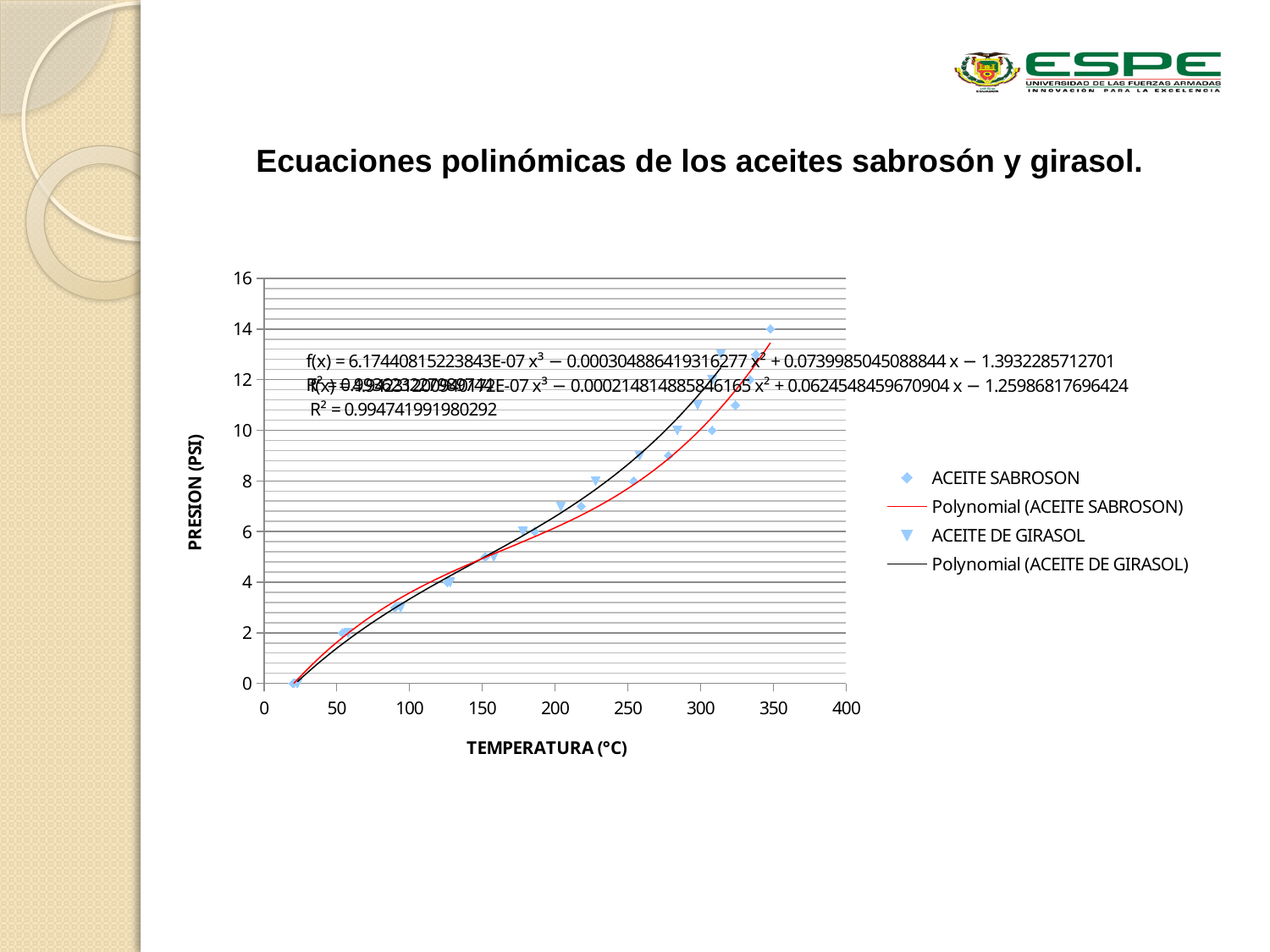
How many entries does the chart legend list? 4 Which series reaches the highest pressure value on the chart, ACEITE SABROSON or ACEITE DE GIRASOL? ACEITE SABROSON What is the title of the x axis? TEMPERATURA (°C) Is the highest ACEITE SABROSON point greater or less than 12 PSI? greater What kind of chart is shown on the slide? scatter chart Do the pressure values rise or fall as temperature increases along the x axis? rise Is the ACEITE SABROSON point near 100 °C greater or less than 4 PSI? less What colour is the Polynomial (ACEITE SABROSON) trendline? red